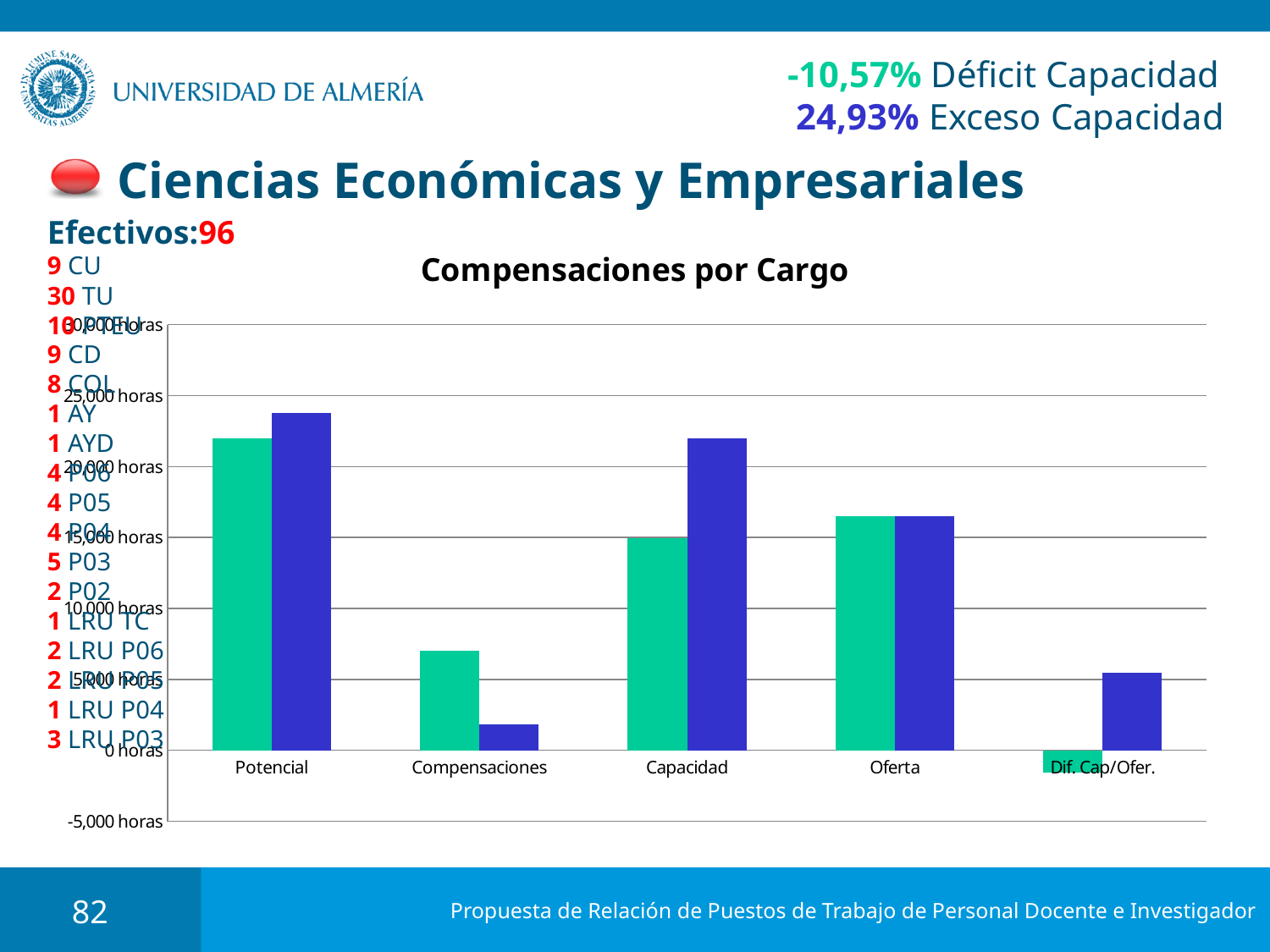
Is the green bar for Potencial greater or less than 20,000 horas? greater Is the blue bar for Capacidad greater or less than 20,000 horas? greater For Compensaciones, which bar is taller, the green one or the blue one? the green one Which category has the shortest blue bar? Compensaciones What kind of chart is shown on the slide? bar chart For Capacidad, which bar is taller, the green one or the blue one? the blue one What is the title of the chart on the slide? Compensaciones por Cargo Is the blue bar for Compensaciones greater or less than 5,000 horas? less How many categories are shown on the x axis of the chart? 5 Which category has the tallest green bar? Potencial Which category has the lowest green bar? Dif. Cap/Ofer.